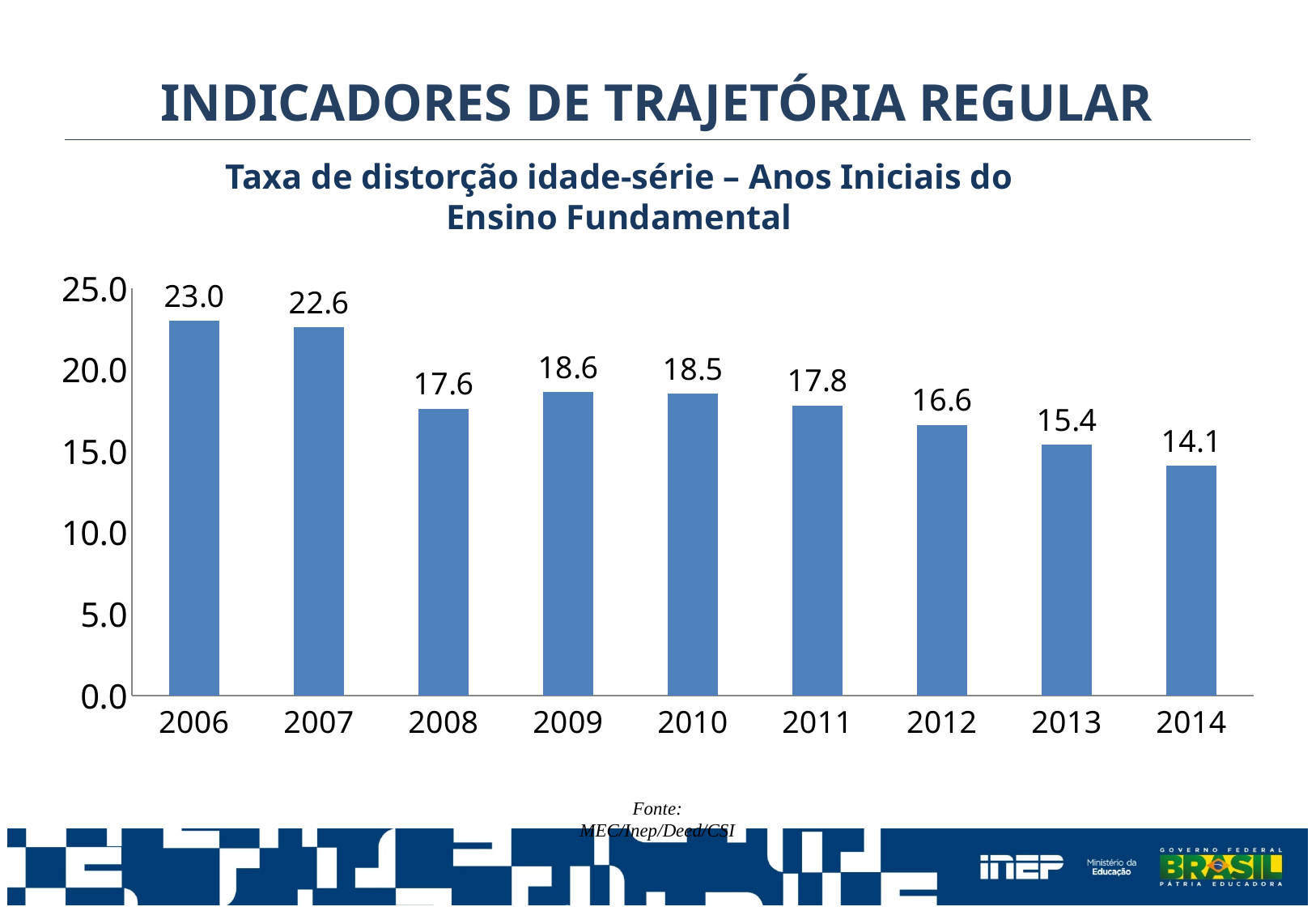
What is the difference between the values for 2008 and 2009? 1.0 What is the difference between the values for 2006 and 2014? 8.9 Is the value for 2012 greater or less than 15.0? greater Which year has the lowest value? 2014 What is the value for 2009? 18.6 What is the value for 2014? 14.1 Which year has the highest value? 2006 What kind of chart is shown on the slide? bar chart What is the value for 2006? 23.0 Which is larger, the value for 2008 or the value for 2011? 2011 Do the values generally rise or fall from 2006 to 2014? fall How many years are shown on the x axis? 9